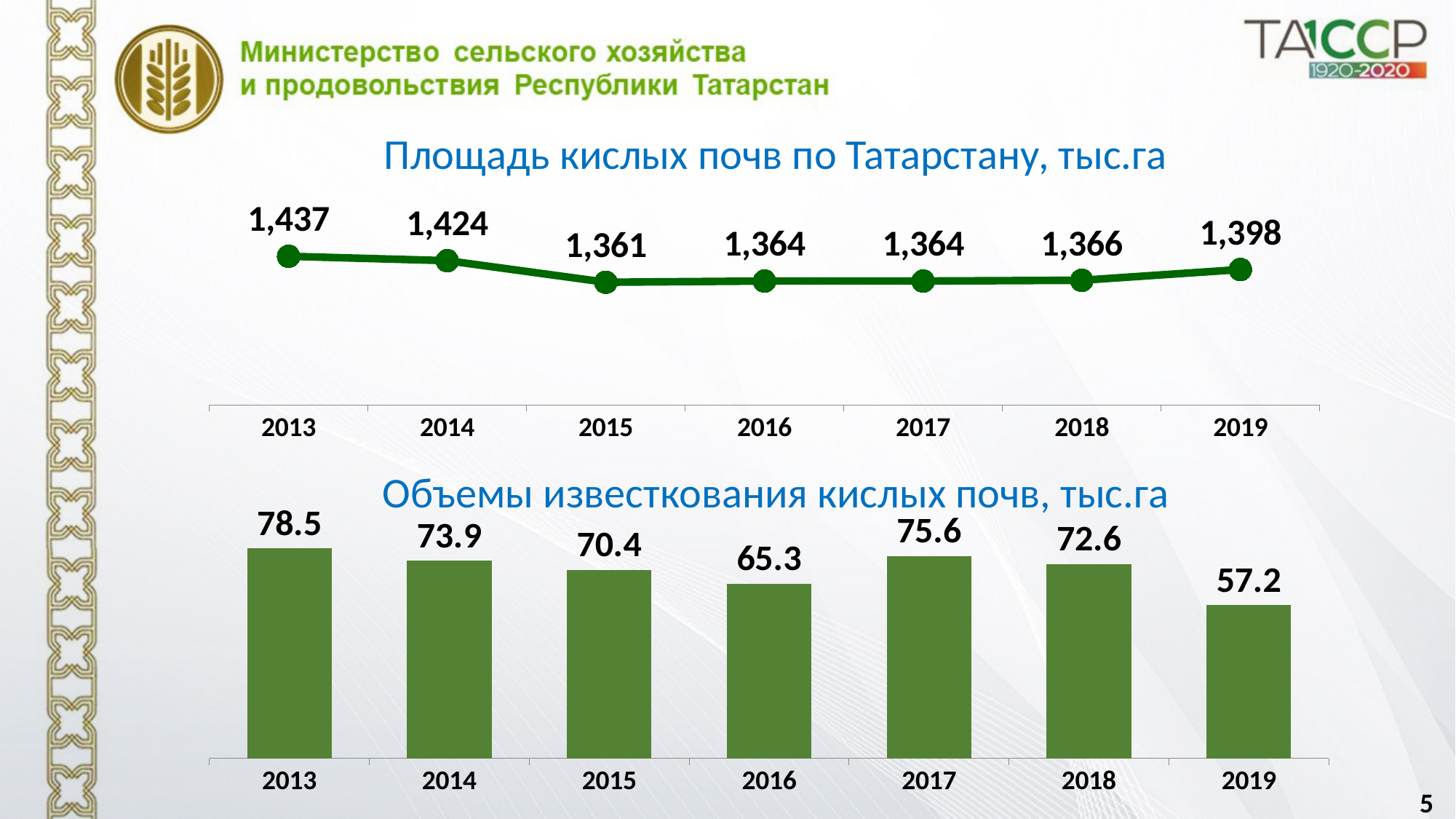
How many years are shown in the bottom chart (Объемы известкования кислых почв, тыс.га)? 7 In the bottom chart (Объемы известкования кислых почв, тыс.га), which year has the lowest value? 2019 In the bottom chart (Объемы известкования кислых почв, тыс.га), what is the value for 2016? 65.3 In the top chart (Площадь кислых почв по Татарстану, тыс.га), what is the value for 2013? 1,437 In the top chart (Площадь кислых почв по Татарстану, тыс.га), which year has the lowest value? 2015 In the top chart (Площадь кислых почв по Татарстану, тыс.га), which year has the highest value? 2013 In the top chart (Площадь кислых почв по Татарстану, тыс.га), what is the difference between the 2013 and 2015 values? 76 In the bottom chart (Объемы известкования кислых почв, тыс.га), which year has the highest value? 2013 What kind of chart is the top chart (Площадь кислых почв по Татарстану, тыс.га)? line chart In the bottom chart (Объемы известкования кислых почв, тыс.га), which is larger, the value for 2017 or the value for 2018? 2017 In the bottom chart (Объемы известкования кислых почв, тыс.га), what is the difference between the 2013 and 2019 values? 21.3 In the top chart (Площадь кислых почв по Татарстану, тыс.га), what is the value for 2019? 1,398